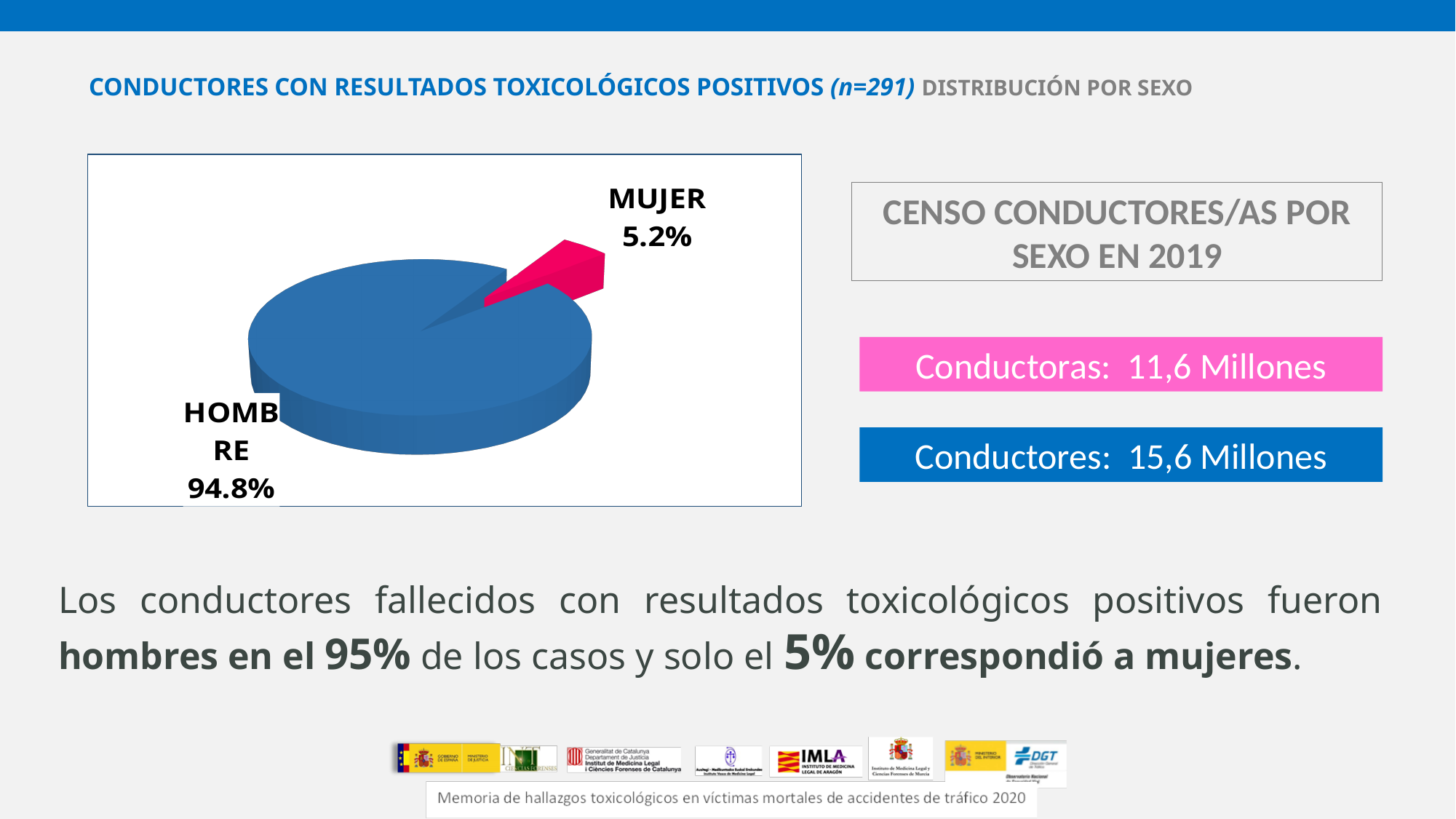
What percentage of the pie chart corresponds to HOMBRE? 94.8% Which category has the largest share of the pie chart? HOMBRE What is the difference in percentage points between the HOMBRE and MUJER slices? 89.6 What kind of chart is shown on the slide? Pie chart What colour is the MUJER slice in the pie chart? Pink What share of the pie does the MUJER slice represent? 5.2% What percentage of the pie chart corresponds to MUJER? 5.2% Which category has the smallest share of the pie chart? MUJER What is the sample size (n) stated in the chart title? 291 How many slices does the pie chart have? 2 Which slice is larger, HOMBRE or MUJER? HOMBRE